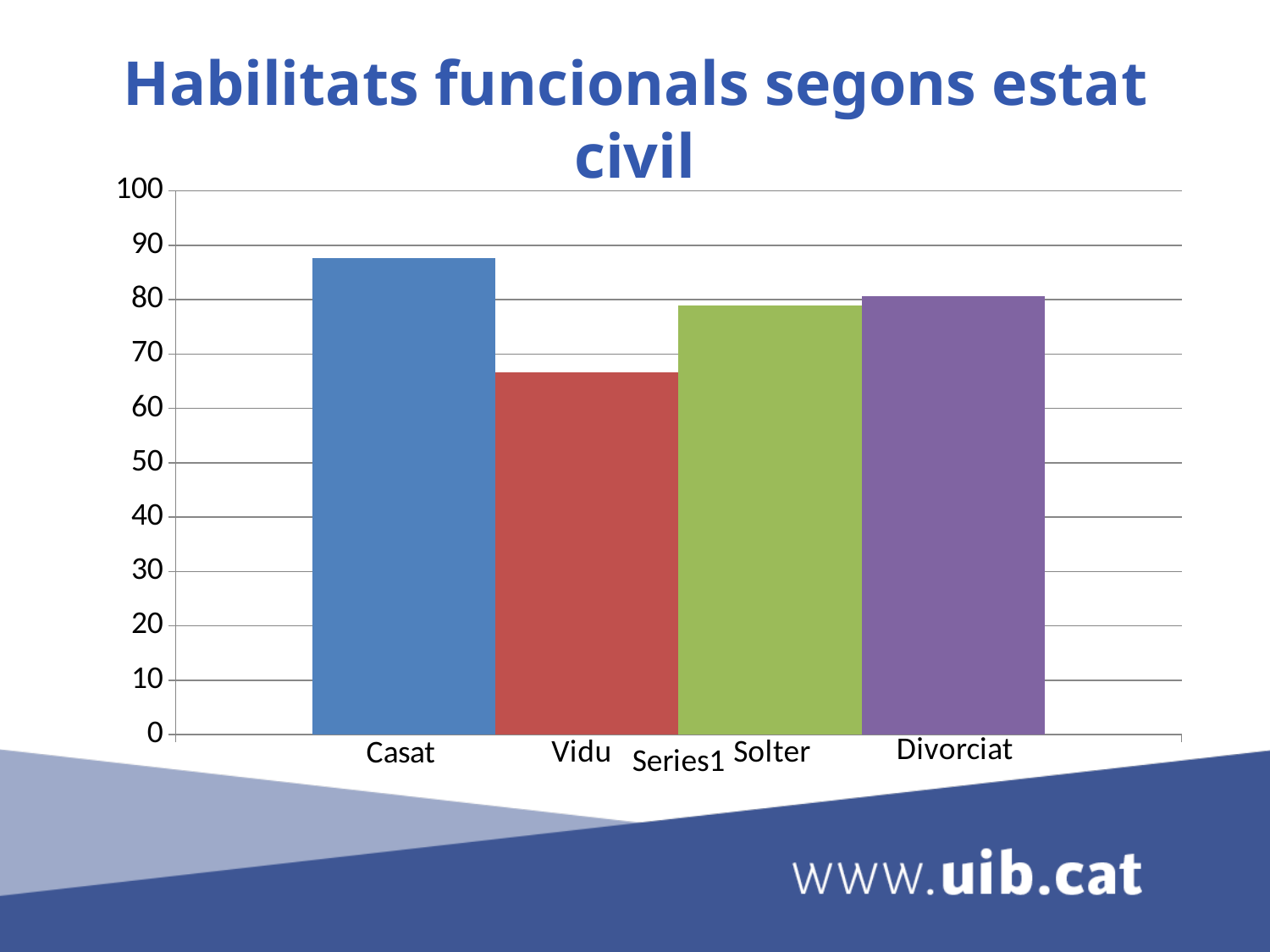
What is the title of the chart? Habilitats funcionals segons estat civil Which is larger, the value for Casat or the value for Vidu? Casat Which category has the highest bar? Casat What kind of chart is shown on the slide? bar chart Is the value for Solter greater or less than 70? greater How many categories are plotted in the chart? 4 Is the value for Vidu greater or less than 70? less Which category has the lowest bar? Vidu Is the value for Casat greater or less than 80? greater Which is larger, the value for Casat or the value for Divorciat? Casat Which is larger, the value for Vidu or the value for Solter? Solter What colour is the bar for Casat? blue